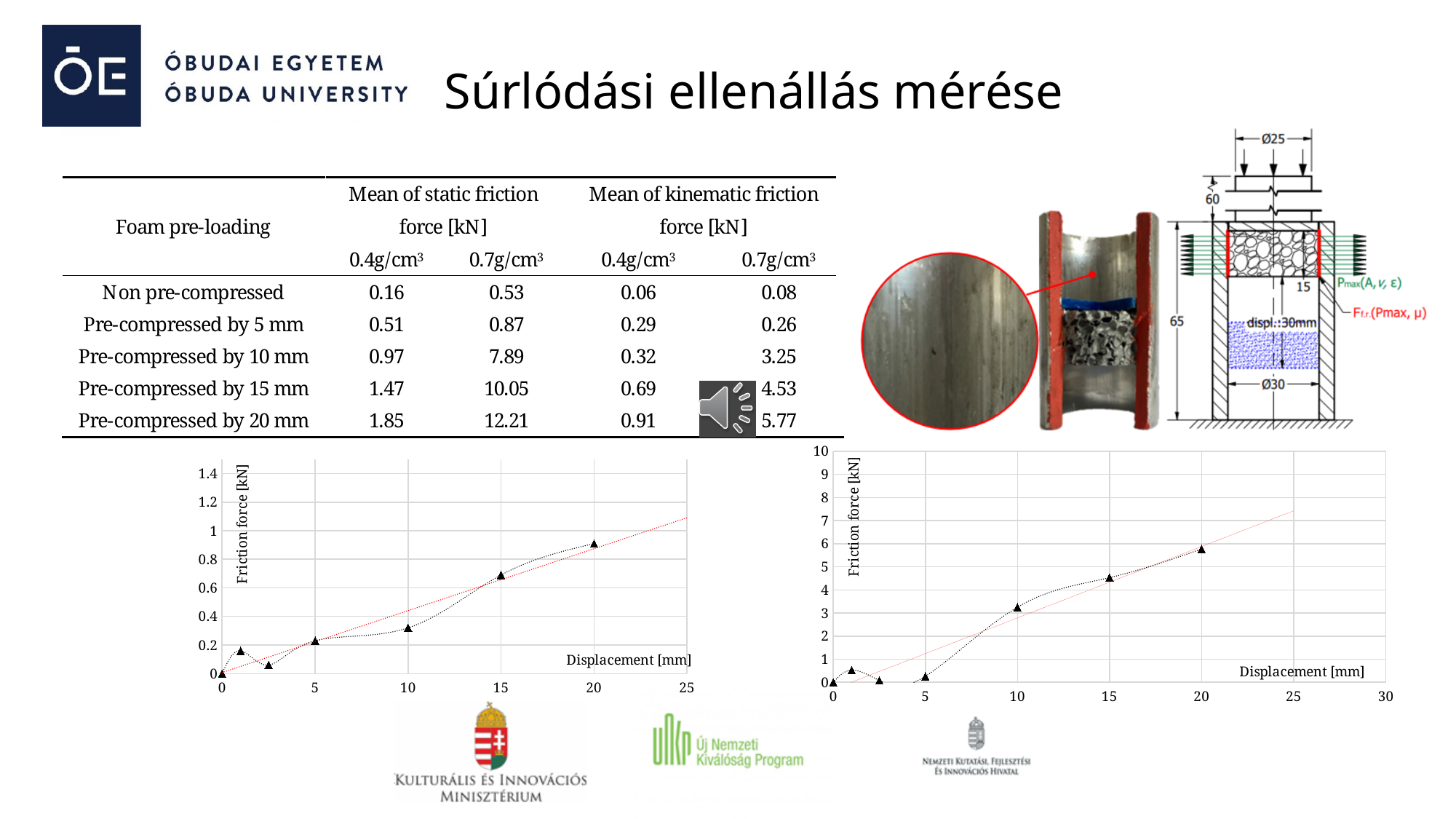
In the bottom-left chart, is the friction force at a displacement of 20 mm greater or less than 0.8 kN? greater What is the x-axis title of the bottom-right chart? Displacement [mm] In the bottom-right chart, is the friction force at a displacement of 10 mm greater or less than 4 kN? less In the bottom-right chart, is the friction force at a displacement of 20 mm greater or less than 5 kN? greater What kind of chart is the chart on the bottom left of the slide? line chart What is the y-axis title of the bottom-left chart? Friction force [kN] In the bottom-left chart, at which displacement is the friction force highest? 20 mm In the bottom-right chart, at which displacement is the friction force highest? 20 mm In the bottom-right chart, which has the larger friction force: a displacement of 10 mm or 15 mm? 15 mm How many data points are plotted in the bottom-left chart? 7 In the bottom-right chart, does the friction force generally rise or fall as displacement increases? rise